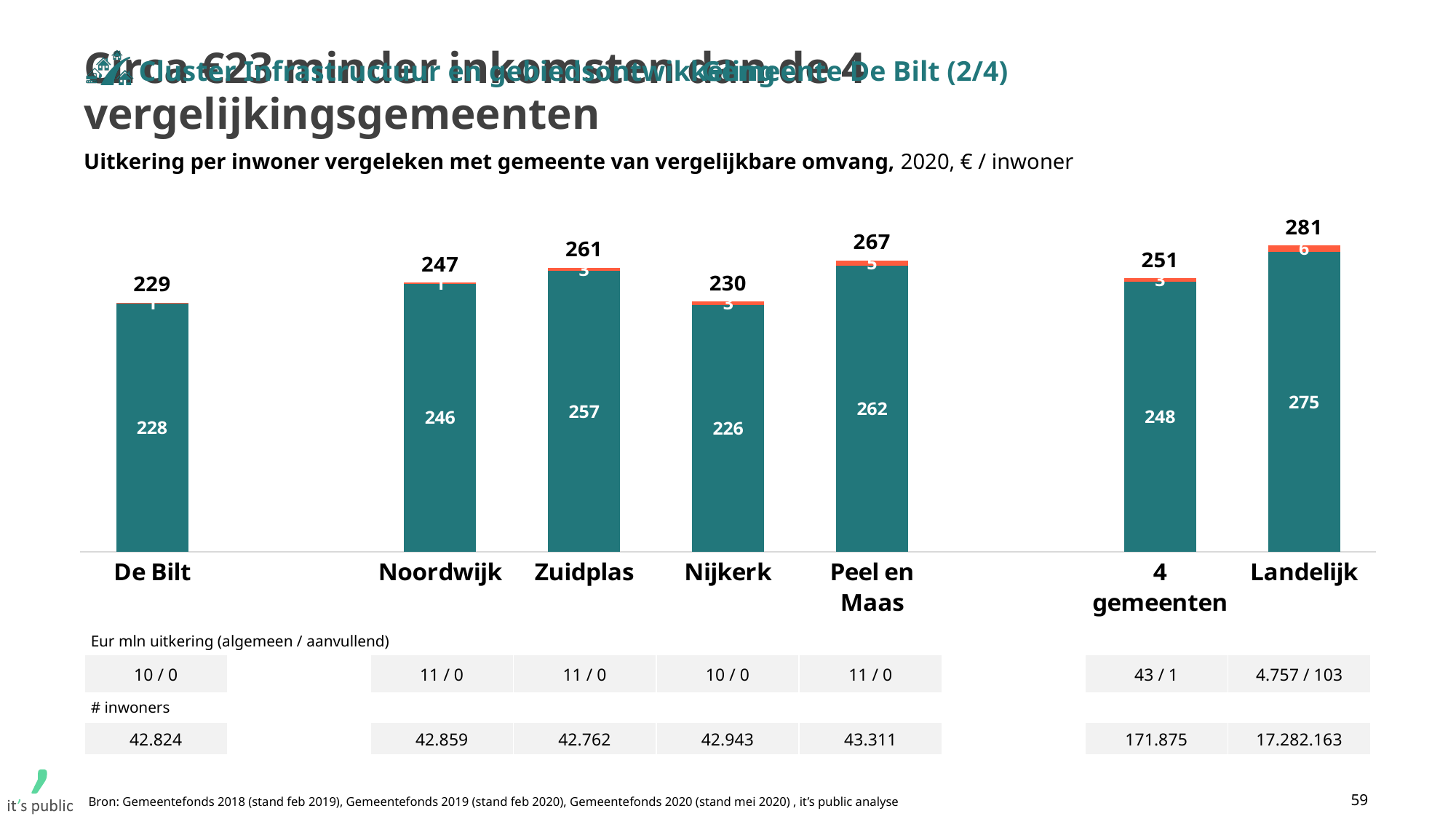
What is the total value shown above the bar for De Bilt? 229 In what unit are the values in the chart expressed, according to the subtitle? € / inwoner Which category has the lowest total value? De Bilt What is the difference between the total for 4 gemeenten and the total for De Bilt? 22 What is the total value shown above the bar for 4 gemeenten? 251 What kind of chart is shown on the slide? Bar chart Which has a higher total value, Noordwijk or Peel en Maas? Peel en Maas Which category has the highest total value? Landelijk What is the value printed inside the large teal segment of the Peel en Maas bar? 262 How many categories (bars) are shown in the chart? 7 What is the value printed inside the large teal segment of the Zuidplas bar? 257 What is the difference between the total for Landelijk and the total for De Bilt? 52